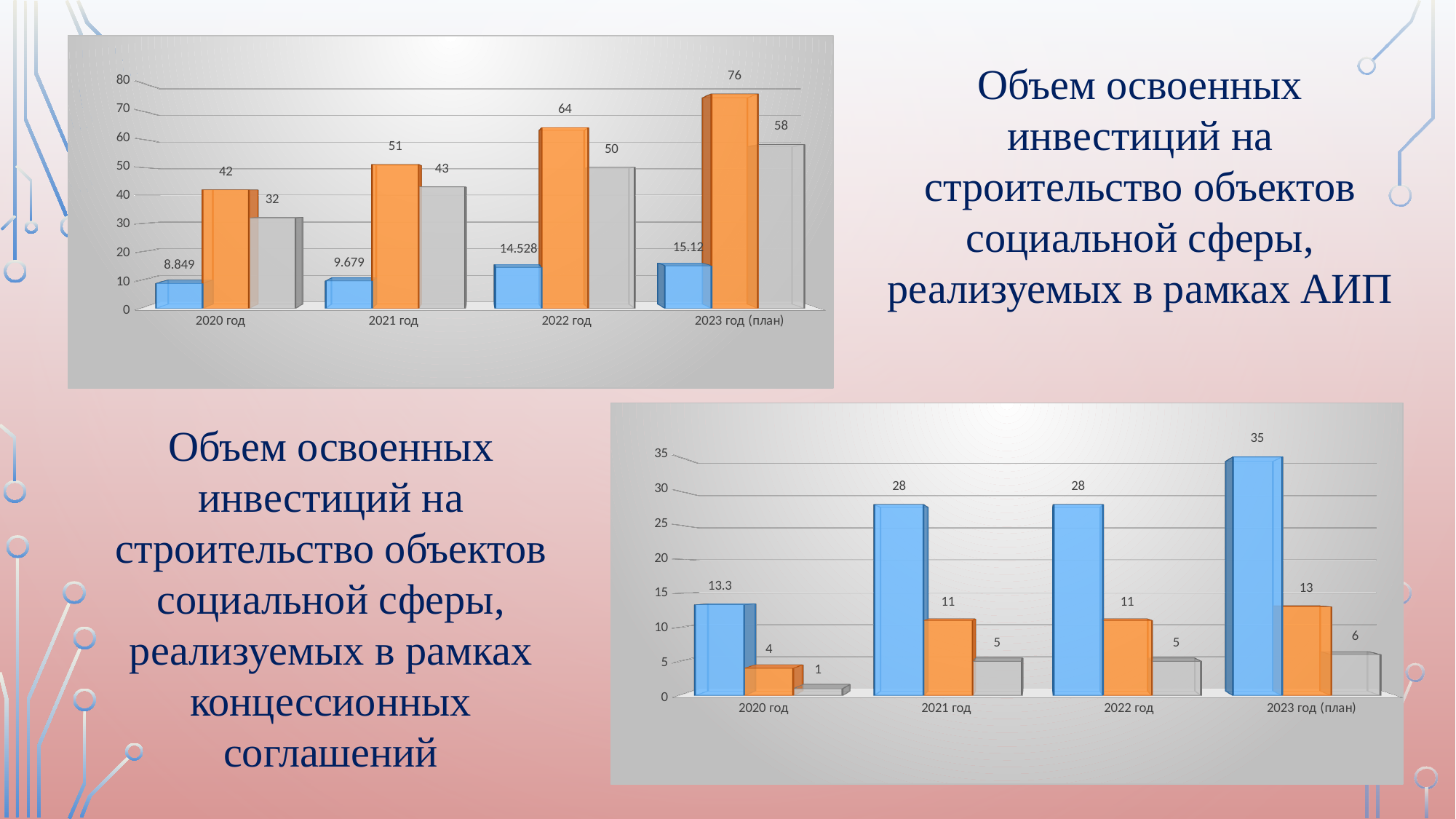
In the bottom chart (концессионных соглашений), what is the difference between the blue bars for 2023 год (план) and 2022 год? 7 In the top chart (АИП), what is the value of the orange bar for 2022 год? 64 How many year categories are shown on the x axis of the bottom chart? 4 In the top chart (АИП), what is the value of the grey bar for 2023 год (план)? 58 In the top chart (АИП), what is the value of the blue bar for 2020 год? 8.849 In the bottom chart (концессионных соглашений), what is the value of the blue bar for 2020 год? 13.3 What type of chart is the top chart? bar chart In the top chart (АИП), which year has the highest orange bar? 2023 год (план) In the top chart (АИП), do the orange bars rise or fall from 2020 год to 2023 год (план)? rise In the top chart (АИП), what is the difference between the orange and grey bars for 2021 год? 8 In the bottom chart (концессионных соглашений), what is the value of the grey bar for 2023 год (план)? 6 In the bottom chart (концессионных соглашений), which year has the lowest grey bar? 2020 год